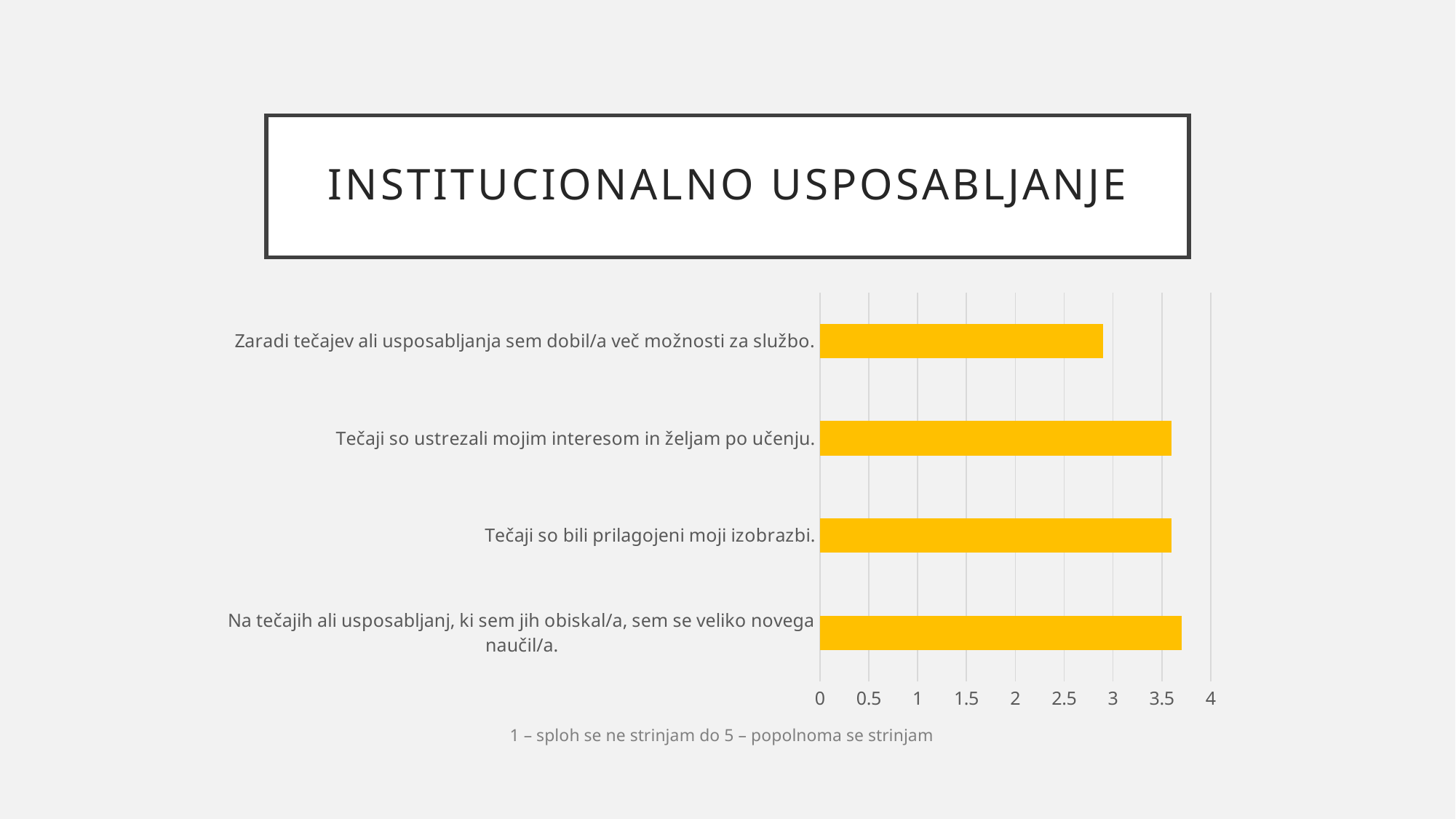
What is the title of the slide containing the chart? INSTITUCIONALNO USPOSABLJANJE What is the maximum value shown on the horizontal axis of the chart? 4 Is the value for "Na tečajih ali usposabljanj, ki sem jih obiskal/a, sem se veliko novega naučil/a." greater or less than 3.5? greater How many categories (statements) are plotted in the chart? 4 Is the value for "Tečaji so bili prilagojeni moji izobrazbi." greater or less than 3? greater Is the value for "Zaradi tečajev ali usposabljanja sem dobil/a več možnosti za službo." greater or less than 3? less What kind of chart is shown on the slide? bar chart Which has a larger value: "Na tečajih ali usposabljanj, ki sem jih obiskal/a, sem se veliko novega naučil/a." or "Zaradi tečajev ali usposabljanja sem dobil/a več možnosti za službo."? Na tečajih ali usposabljanj, ki sem jih obiskal/a, sem se veliko novega naučil/a. Which statement has the lowest value in the chart? Zaradi tečajev ali usposabljanja sem dobil/a več možnosti za službo. Which has a larger value: "Zaradi tečajev ali usposabljanja sem dobil/a več možnosti za službo." or "Tečaji so ustrezali mojim interesom in željam po učenju."? Tečaji so ustrezali mojim interesom in željam po učenju.